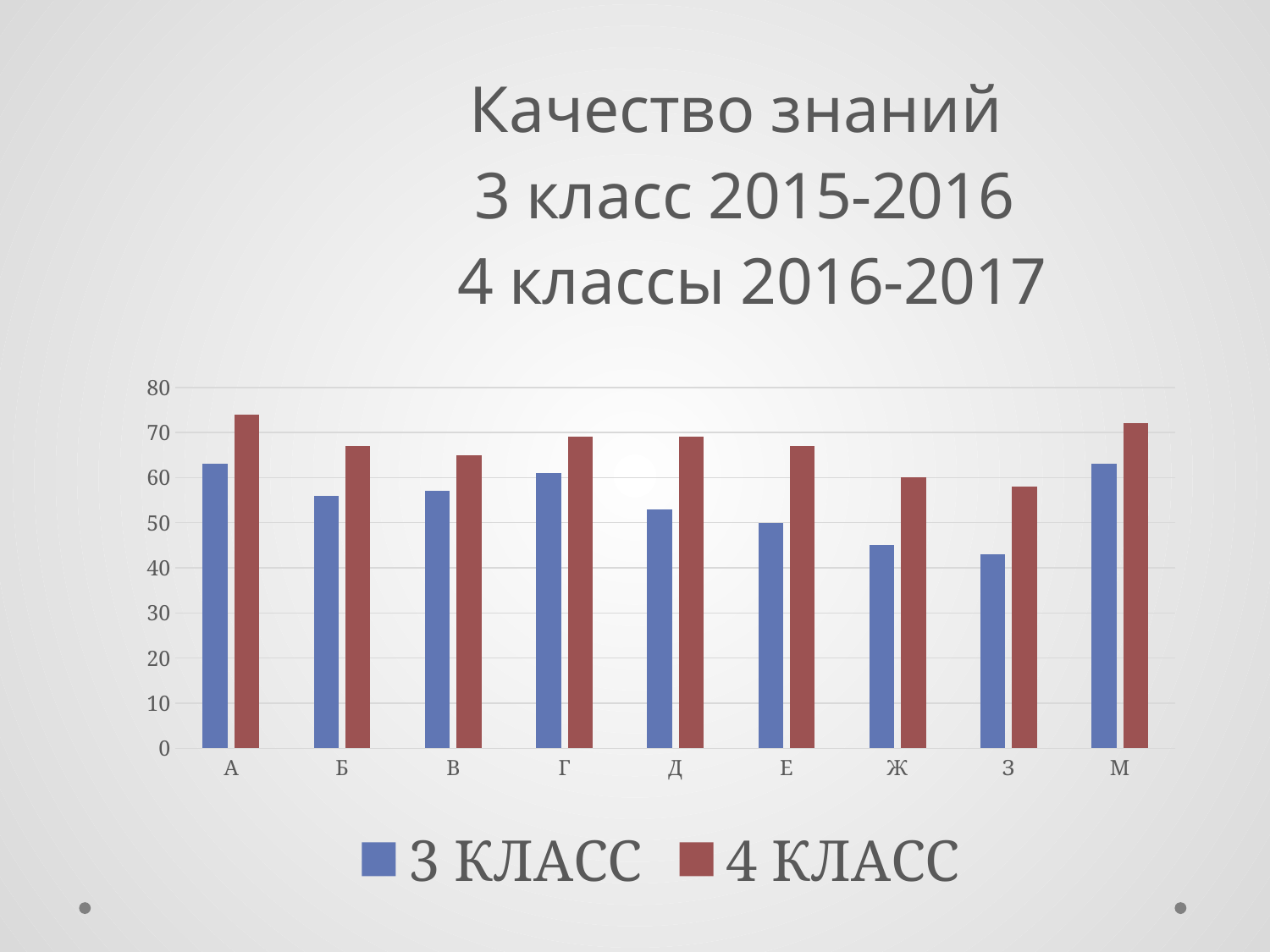
What are the two series named in the legend? 3 КЛАСС and 4 КЛАСС Is the 4 КЛАСС value for А greater or less than 70? greater Which colour represents the 4 КЛАСС series? red Is the 4 КЛАСС value for Б greater or less than 60? greater Is the 3 КЛАСС value for З greater or less than 50? less How many series does the legend list? 2 How many categories are shown on the x axis of the chart? 9 What kind of chart is shown on the slide? bar chart For the 3 КЛАСС series, which is larger: the value for А or the value for Е? А For the 4 КЛАСС series, which is larger: the value for А or the value for З? А